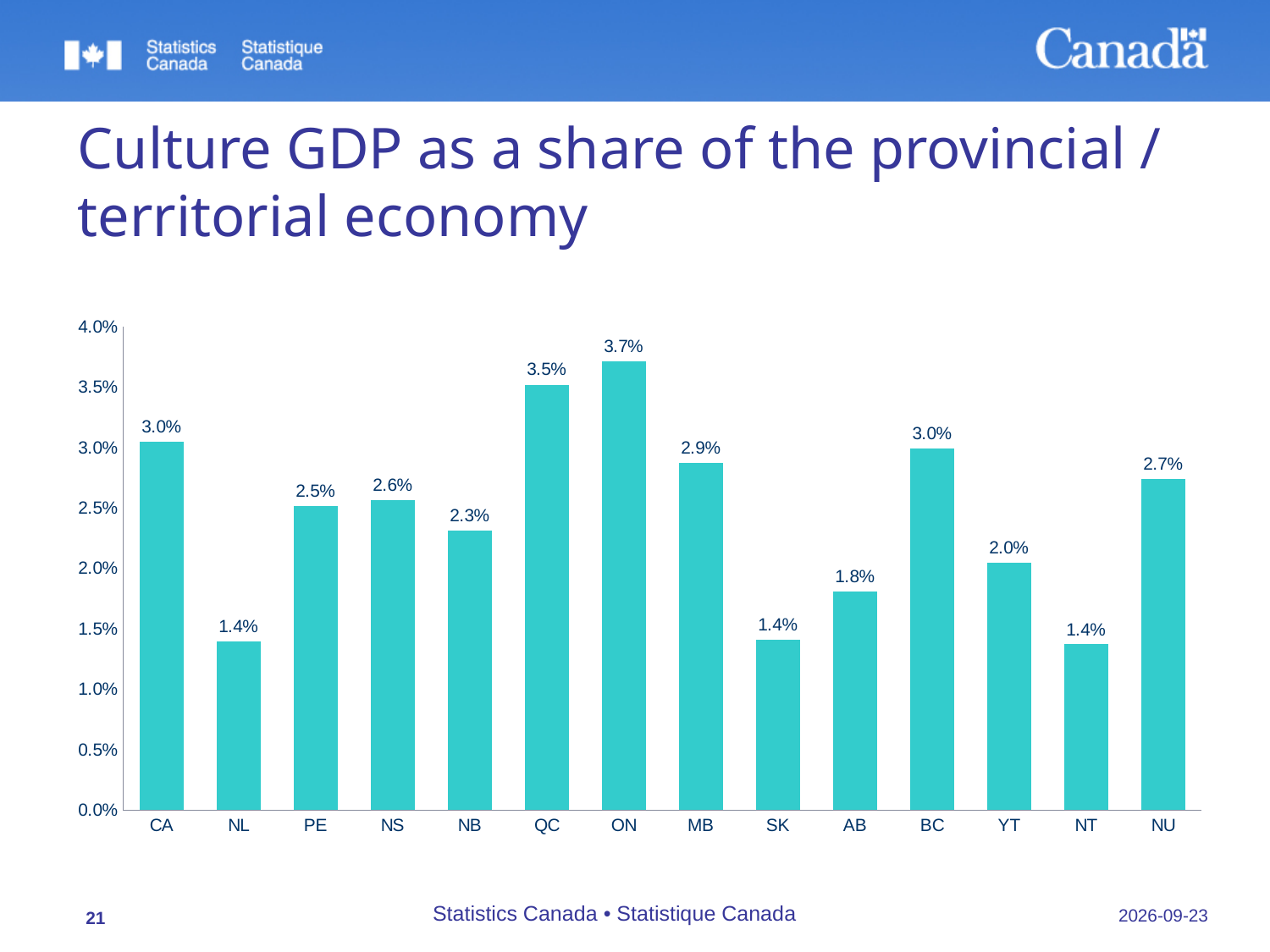
Is the value for NB greater or less than 2.5%? less What is the value shown for Quebec (QC)? 3.5% What kind of chart is shown on the slide? bar chart What is the difference between the values for CA and NL? 1.6 percentage points Which is larger, the value for QC or the value for MB? QC What is the value shown for Nunavut (NU)? 2.7% How many provinces, territories and national categories are shown on the x axis? 14 Which province or territory has the highest culture GDP share? ON What is the title of the slide? Culture GDP as a share of the provincial / territorial economy What is the value shown for Alberta (AB)? 1.8% What is the difference between the values for ON and QC? 0.2 percentage points What is the culture GDP share for Ontario (ON)? 3.7%